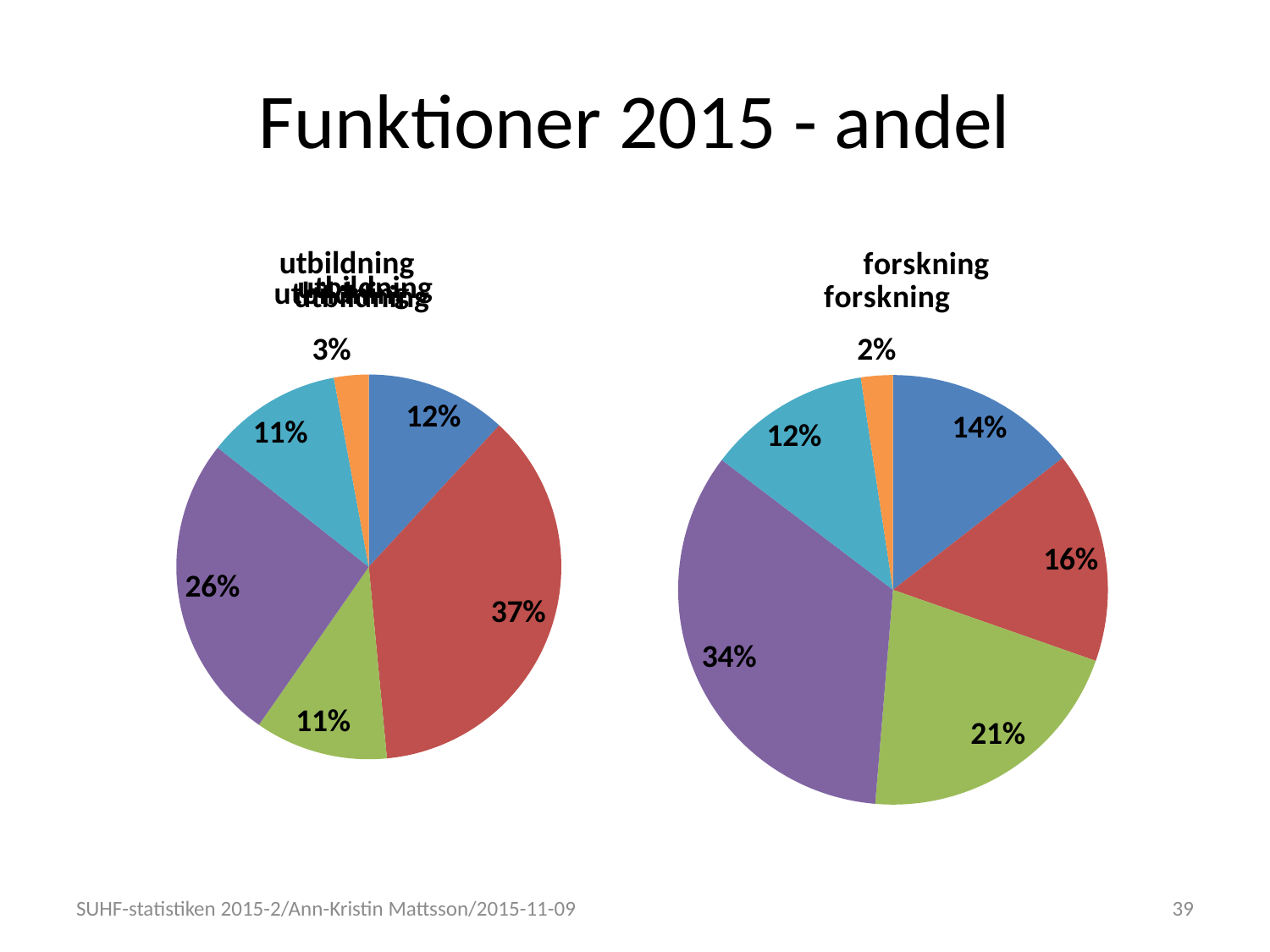
How many pie charts are shown on the slide? 2 In the "utbildning" pie chart, what is the difference between the red slice (37%) and the purple slice (26%)? 11 percentage points How many slices does the "forskning" pie chart have? 6 What is the title of the slide? Funktioner 2015 - andel In the "forskning" pie chart, what share does the green slice have? 21% In the "utbildning" pie chart, what share does the orange slice have? 3% In the "forskning" pie chart, what is the share of the smallest slice? 2% Which is larger: the blue slice in the "utbildning" chart or the blue slice in the "forskning" chart? the blue slice in the "forskning" chart In the "forskning" pie chart, what is the difference between the purple slice (34%) and the red slice (16%)? 18 percentage points In the "forskning" pie chart, what share does the purple slice have? 34% What kind of chart is the left chart titled "utbildning"? pie chart In the "utbildning" pie chart, what is the share of the largest slice? 37%